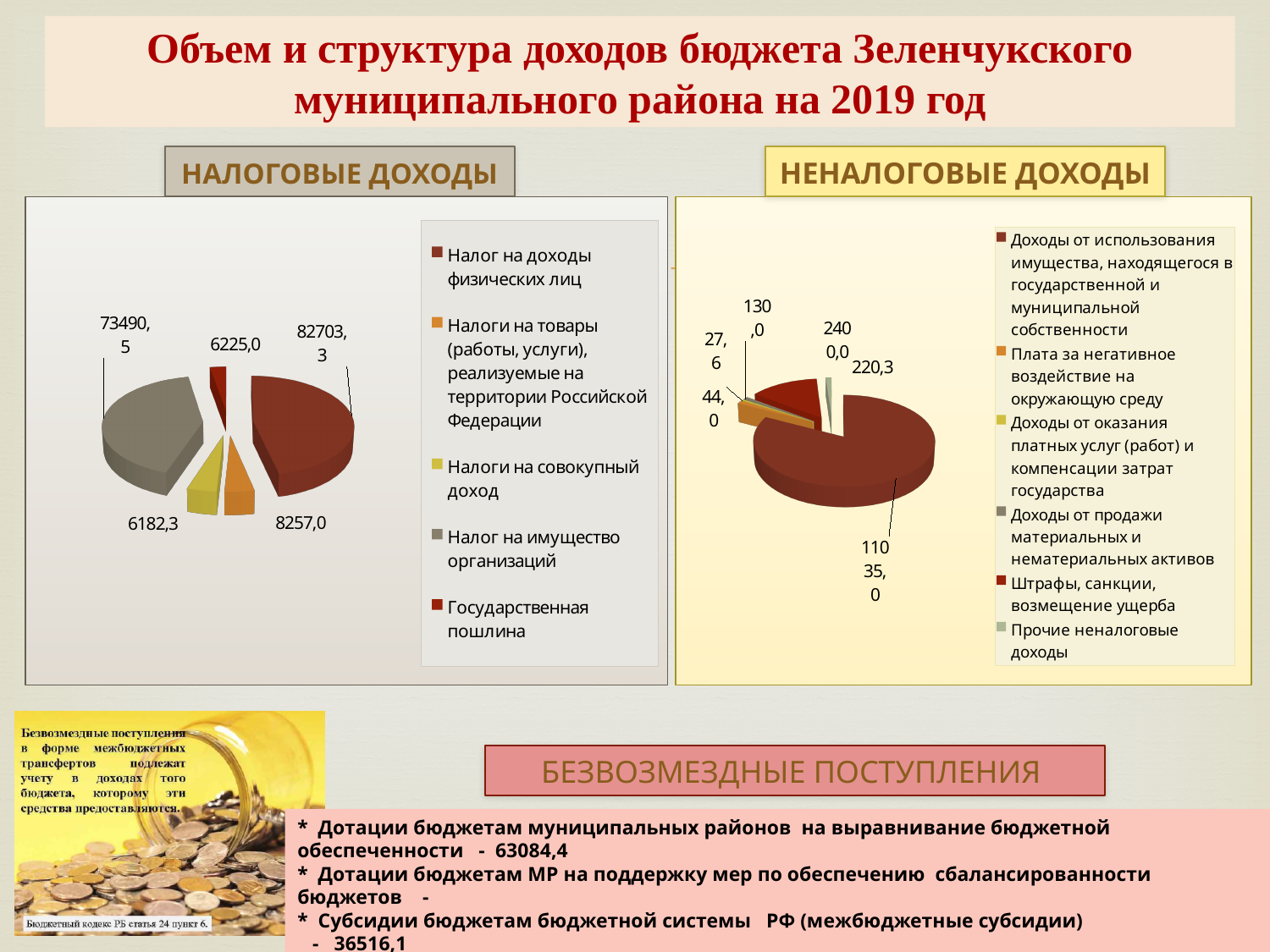
In the НЕНАЛОГОВЫЕ ДОХОДЫ chart, what is the value of the largest slice? 11035,0 What kind of chart is shown under the heading НАЛОГОВЫЕ ДОХОДЫ? Pie chart What kind of chart is shown under the heading НЕНАЛОГОВЫЕ ДОХОДЫ? Pie chart In the НАЛОГОВЫЕ ДОХОДЫ chart, which is larger: Налоги на товары (работы, услуги) or Налоги на совокупный доход? Налоги на товары (работы, услуги) In the НАЛОГОВЫЕ ДОХОДЫ chart, what is the difference between Налог на доходы физических лиц and Налог на имущество организаций? 9212,8 In the НАЛОГОВЫЕ ДОХОДЫ chart, which category has the largest value? Налог на доходы физических лиц How many entries does the legend of the НАЛОГОВЫЕ ДОХОДЫ chart list? 5 In the НАЛОГОВЫЕ ДОХОДЫ chart, what is the value for Налог на доходы физических лиц? 82703,3 In the НАЛОГОВЫЕ ДОХОДЫ chart, what is the value for Государственная пошлина? 6225,0 In the НАЛОГОВЫЕ ДОХОДЫ chart, what is the value for Налоги на совокупный доход? 6182,3 In the НАЛОГОВЫЕ ДОХОДЫ chart, what is the value for Налог на имущество организаций? 73490,5 How many entries does the legend of the НЕНАЛОГОВЫЕ ДОХОДЫ chart list? 6